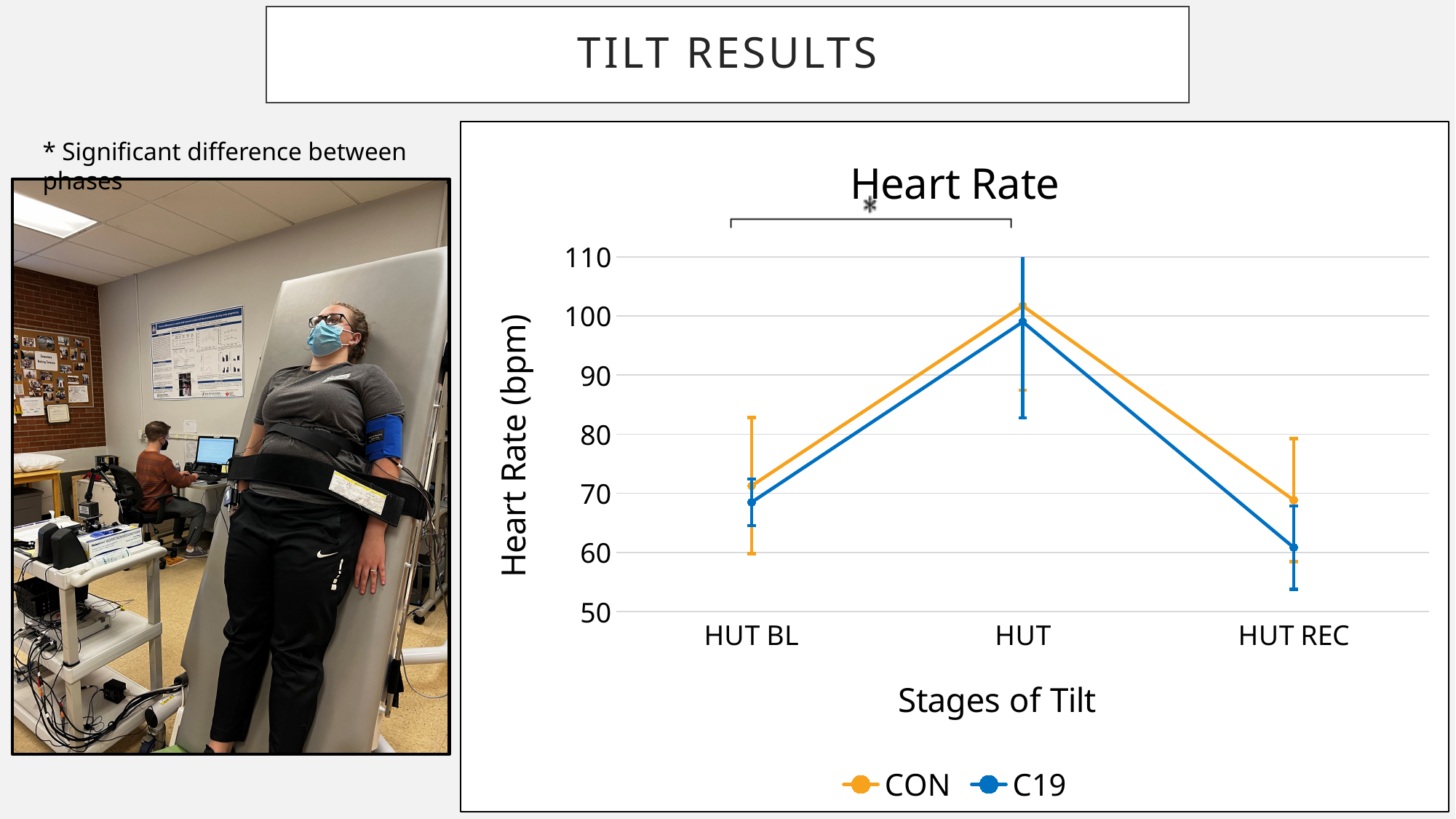
At which stage of tilt is the C19 heart rate lowest? HUT REC Does the heart rate rise or fall from HUT to HUT REC for both series? fall Is the CON heart rate at HUT greater or less than 90 bpm? greater What is the label of the y axis? Heart Rate (bpm) At which stage of tilt is the CON heart rate highest? HUT Is the C19 heart rate at HUT REC greater or less than 70 bpm? less At HUT REC, which series has the higher heart rate, CON or C19? CON How many series does the legend list? 2 What kind of chart is shown on the slide? line chart How many stages of tilt are shown on the x axis? 3 What is the title of the chart? Heart Rate Is the C19 heart rate at HUT BL greater or less than 60 bpm? greater